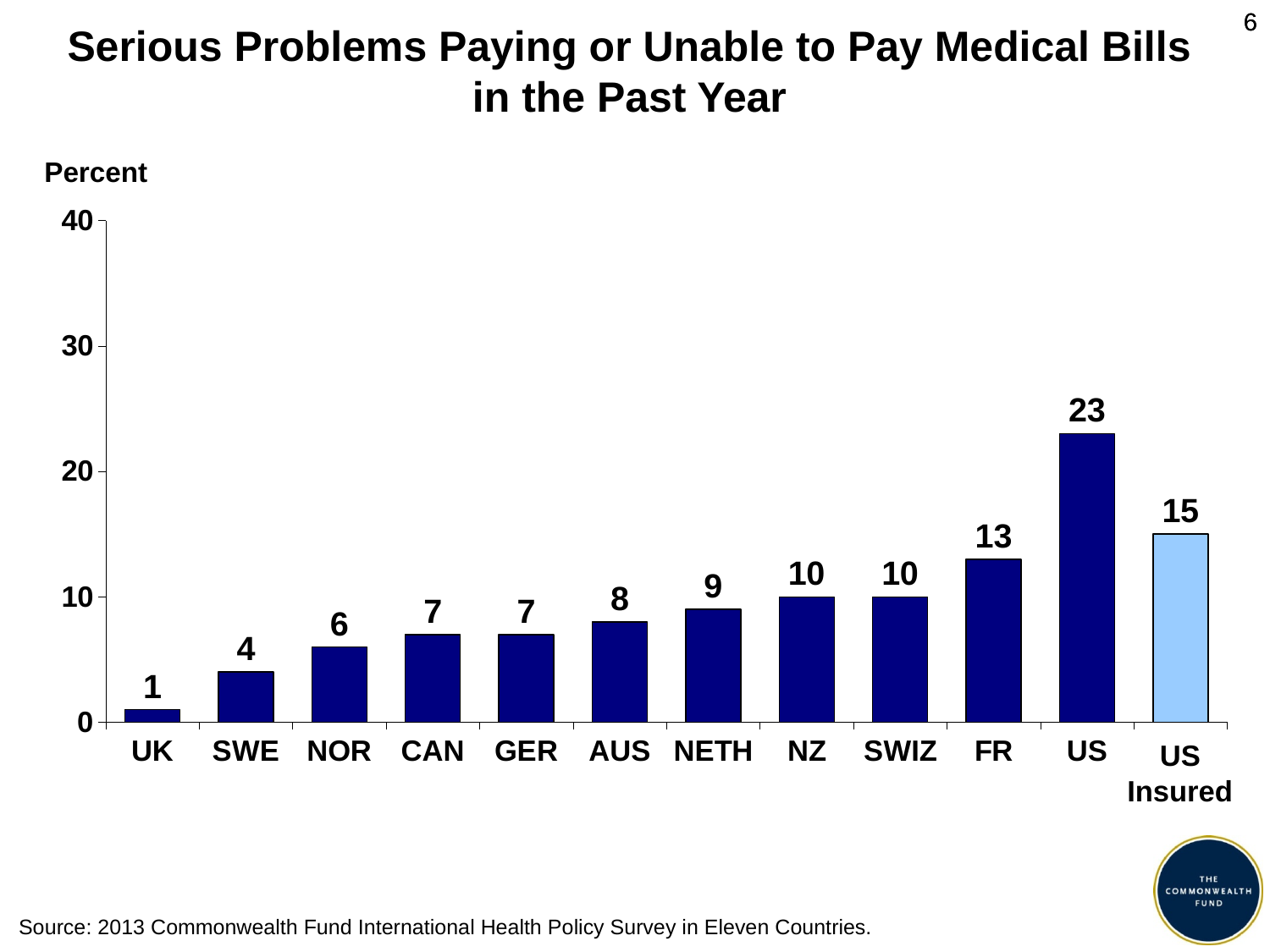
Is the value for the US greater or less than 20? greater What is the difference between the US and US Insured values? 8 What is the difference between the FR and UK values? 12 Which is larger, the value for NETH or the value for AUS? NETH How many bars are shown in the chart? 12 What kind of chart is shown on the slide? Bar chart Which country has the highest value? US Which country has the lowest value? UK What is the value for the US? 23 What is the value for US Insured? 15 Which bar is shown in a lighter blue colour than the others? US Insured What is the value for SWE? 4